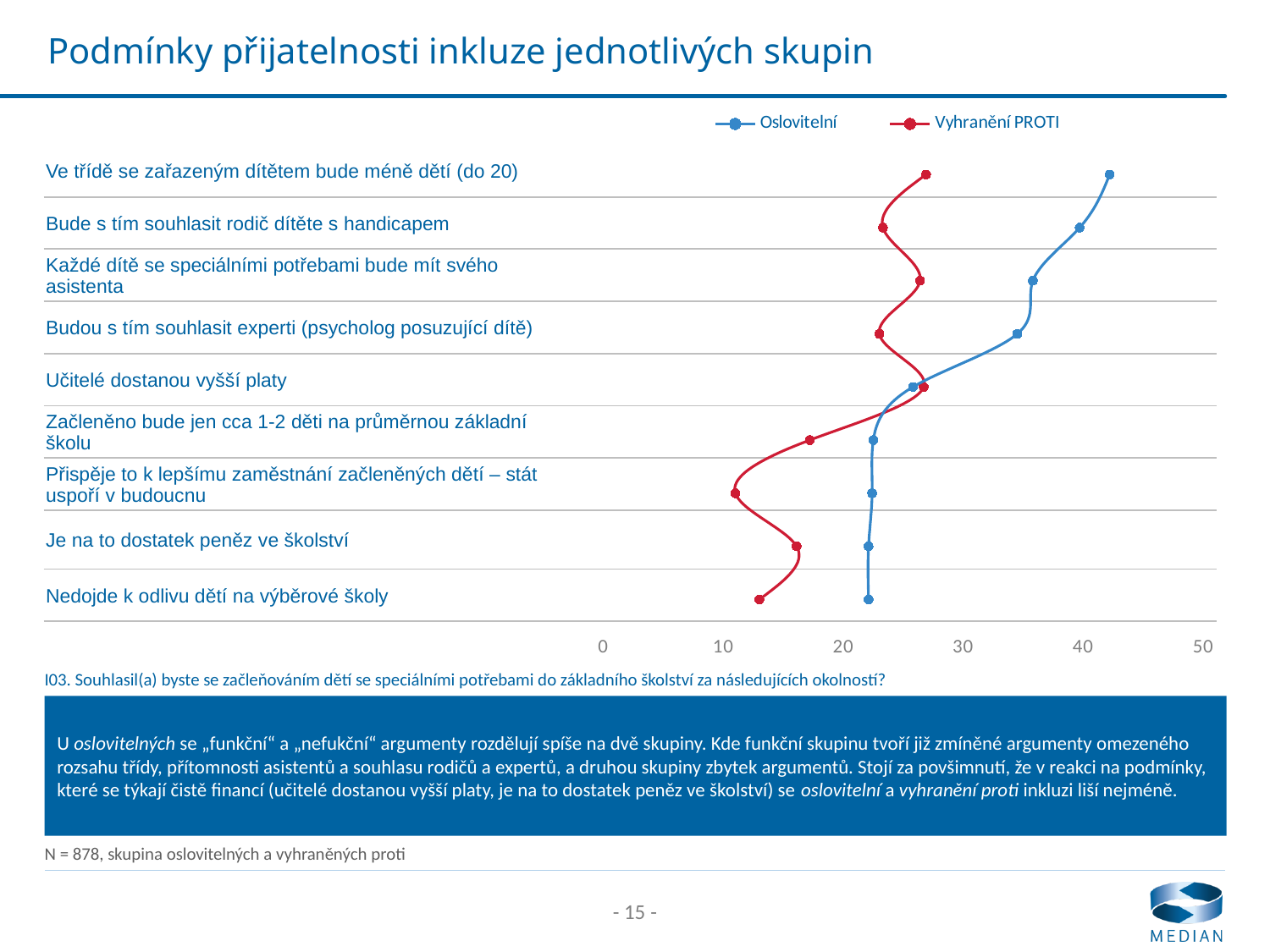
Is the Vyhranění PROTI value for 'Ve třídě se zařazeným dítětem bude méně dětí (do 20)' greater or less than 20? greater For 'Nedojde k odlivu dětí na výběrové školy', which series has the larger value, Oslovitelní or Vyhranění PROTI? Oslovitelní How many series does the legend list? 2 For which category is the Vyhranění PROTI value lowest? Přispěje to k lepšímu zaměstnání začleněných dětí – stát uspoří v budoucnu What kind of chart is shown on the slide? line chart For which category is the Oslovitelní value highest? Ve třídě se zařazeným dítětem bude méně dětí (do 20) For 'Bude s tím souhlasit rodič dítěte s handicapem', which series has the larger value, Oslovitelní or Vyhranění PROTI? Oslovitelní How many categories (conditions) are plotted on the chart? 9 Is the Oslovitelní value for 'Ve třídě se zařazeným dítětem bude méně dětí (do 20)' greater or less than 40? greater Is the Vyhranění PROTI value for 'Přispěje to k lepšímu zaměstnání začleněných dětí – stát uspoří v budoucnu' greater or less than 20? less What colour is the Vyhranění PROTI series in the legend? red